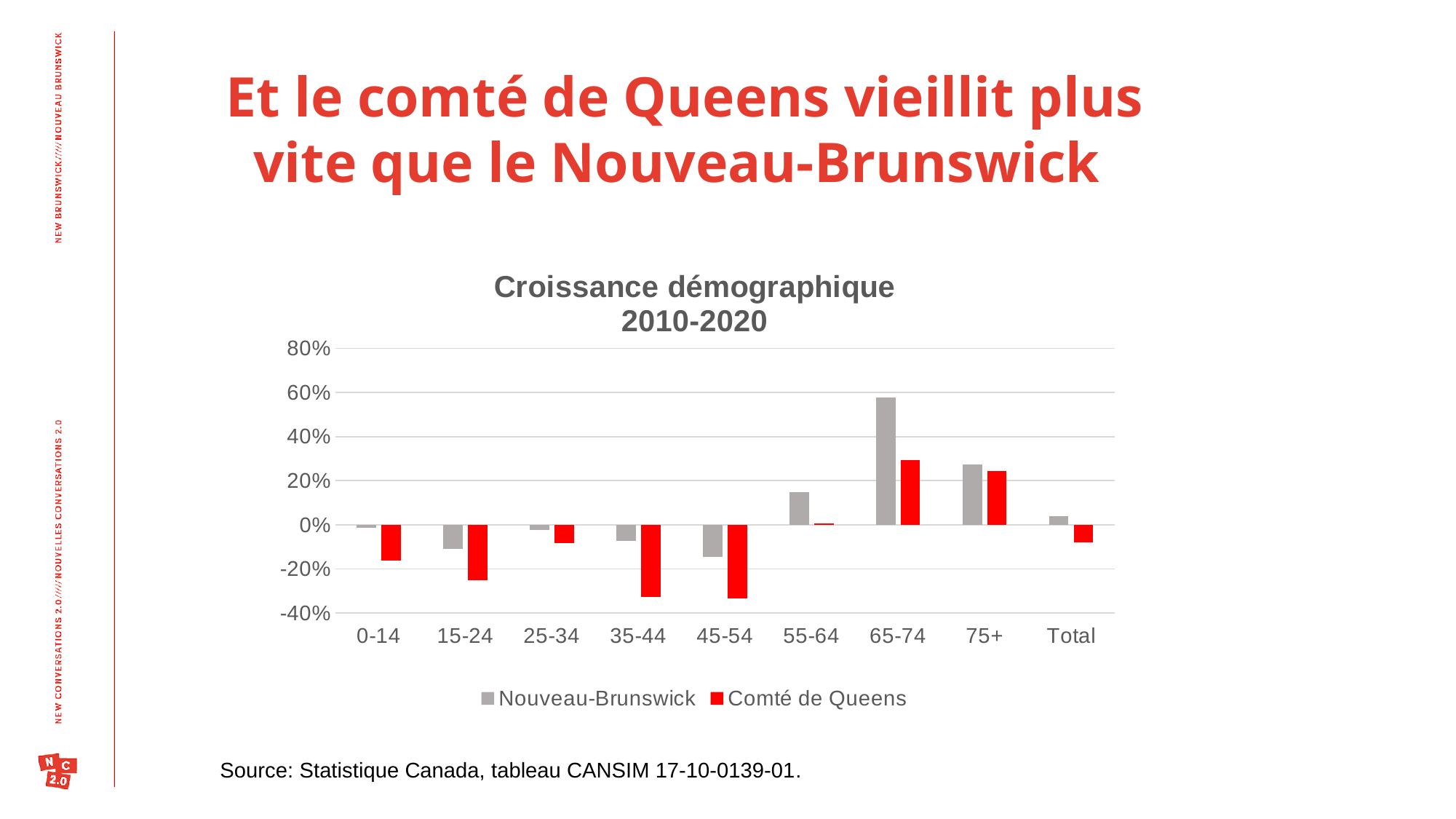
Is the value for Nouveau-Brunswick in the 55-64 group greater or less than 20%? less Is the value for Nouveau-Brunswick in the 65-74 group greater or less than 40%? greater For the Total category, which is larger: Nouveau-Brunswick or Comté de Queens? Nouveau-Brunswick Which age group has the highest value for Comté de Queens? 65-74 Which age group has the lowest value for Nouveau-Brunswick? 45-54 Which age group has the highest value for Nouveau-Brunswick? 65-74 How many categories are shown on the x axis? 9 What kind of chart is shown on the slide? bar chart Is the value for Comté de Queens in the 35-44 group greater or less than -20%? less For the 65-74 group, which is larger: Nouveau-Brunswick or Comté de Queens? Nouveau-Brunswick How many series does the legend list? 2 What is the title of the chart? Croissance démographique 2010-2020